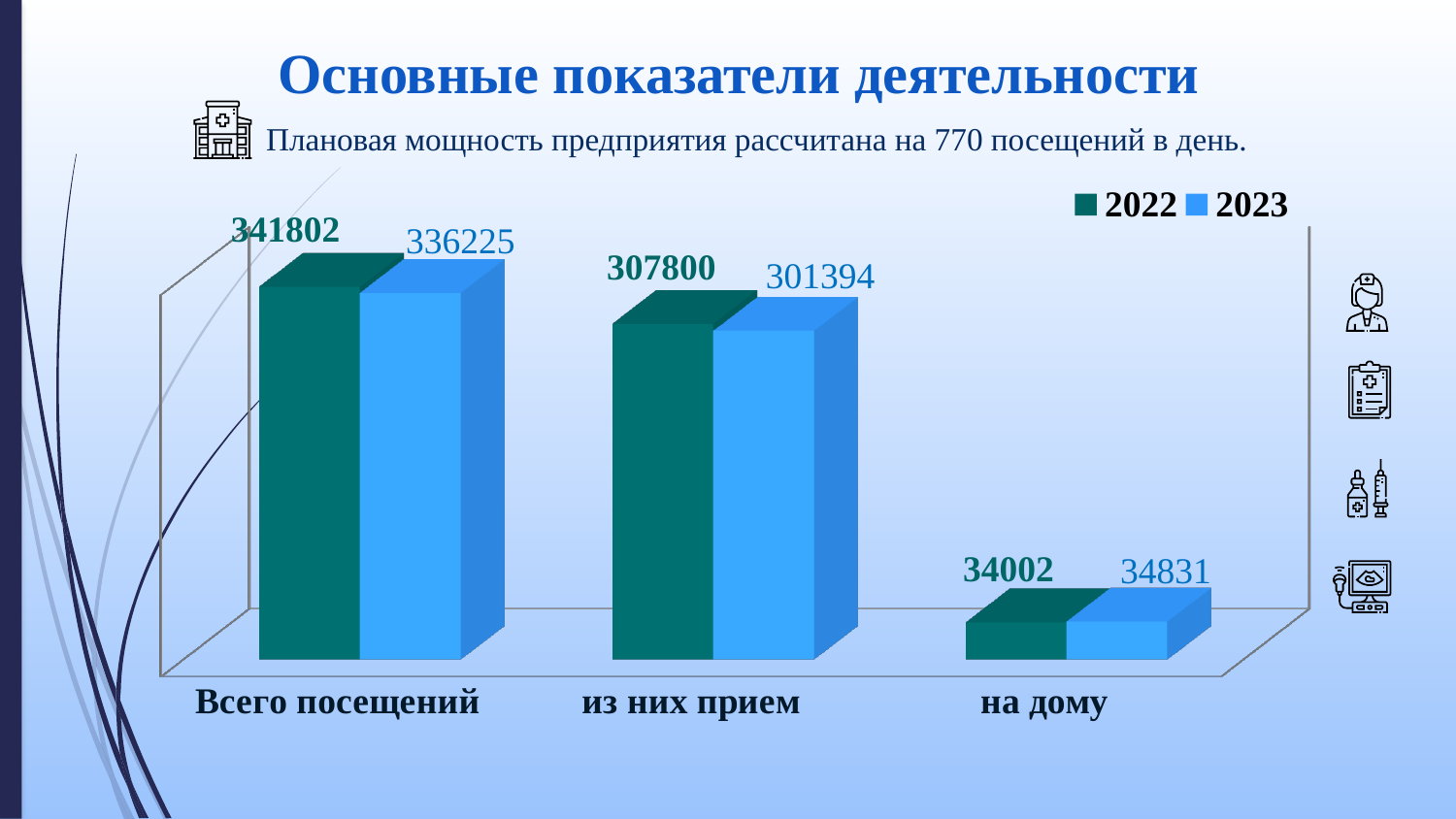
What type of chart is shown on the slide? Bar chart How many series does the chart legend list? 2 How many categories are shown on the x axis of the chart? 3 What is the value for 2022 in the "Всего посещений" category? 341802 Which category has the highest value for 2022? Всего посещений What is the value for 2023 in the "из них прием" category? 301394 What is the difference between the 2022 and 2023 values for "из них прием"? 6406 Which category has the lowest values for both series? на дому What is the value for 2023 in the "на дому" category? 34831 In the "на дому" category, which year has the larger value, 2022 or 2023? 2023 What is the value for 2022 in the "на дому" category? 34002 What is the difference between the 2022 and 2023 values for "Всего посещений"? 5577